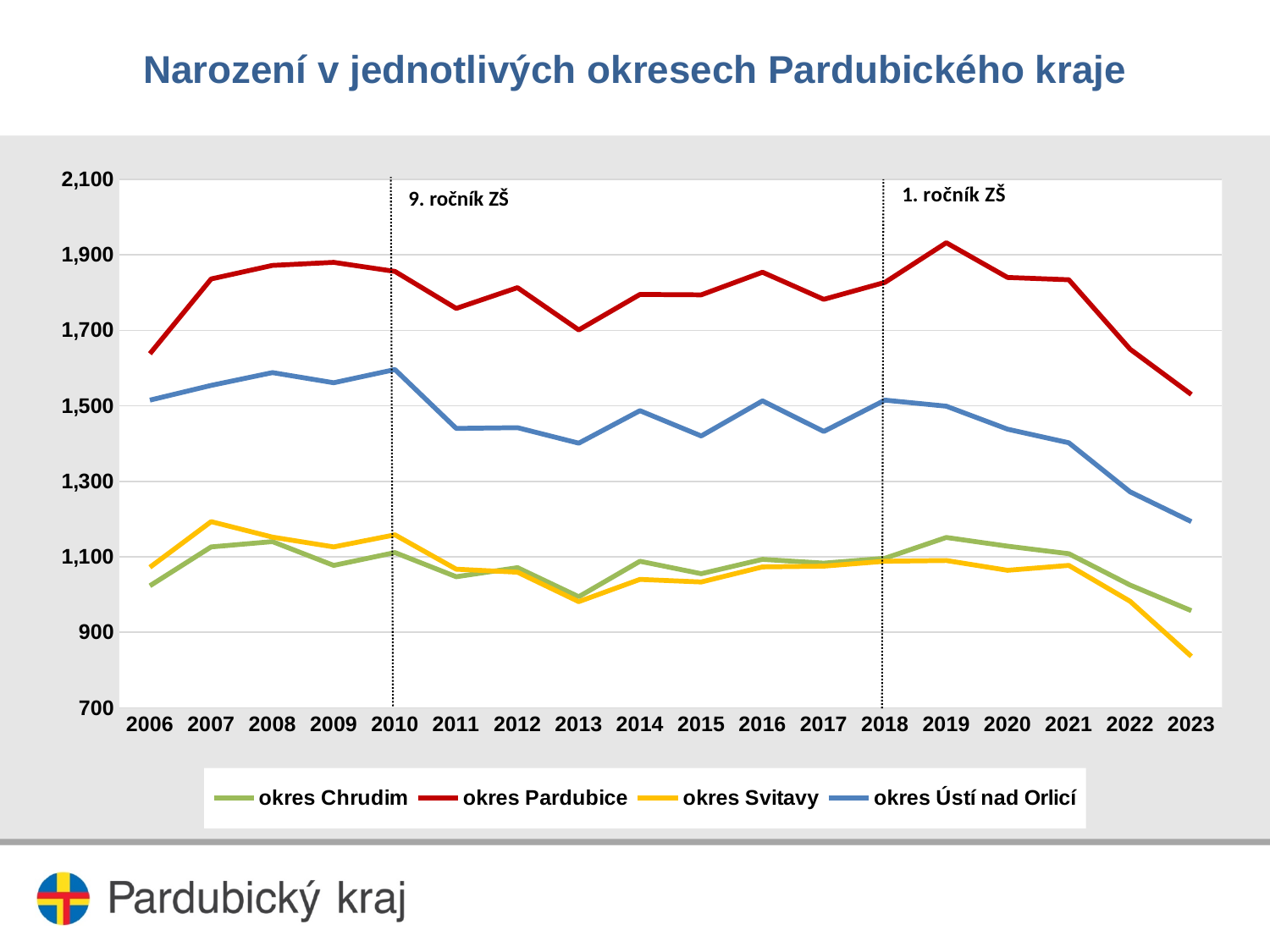
Is the value for okres Pardubice in 2019 greater or less than 1,900? greater Is the value for okres Ústí nad Orlicí in 2023 greater or less than 1,300? less In 2023, which is larger: okres Chrudim or okres Svitavy? okres Chrudim Which series has the highest values across the whole period? okres Pardubice How many series does the legend list? 4 What kind of chart is shown on the slide? line chart How many years are plotted along the x axis? 18 Do the values for okres Ústí nad Orlicí rise or fall from 2018 to 2023? fall What label is written next to the dotted vertical line at 2018? 1. ročník ZŠ In which year does okres Pardubice reach its highest value? 2019 In which year does okres Svitavy reach its lowest value? 2023 Is the value for okres Svitavy in 2023 greater or less than 900? less